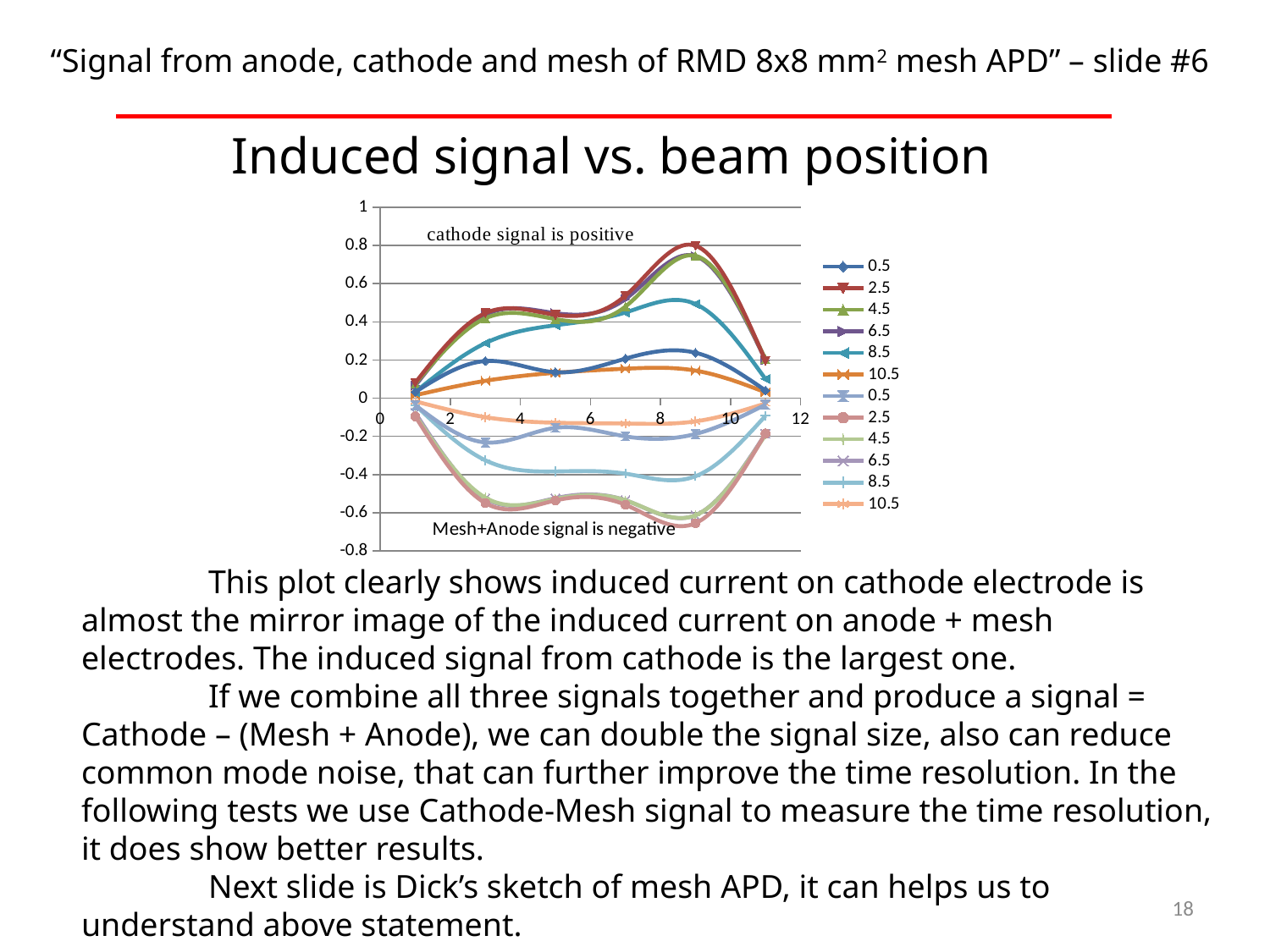
Is the value of the lower 6.5 series at x = 4 greater or less than -0.4? less Is the peak value of the upper 2.5 series (near x = 9) greater or less than 0.6? greater How many series does the legend of the chart list? 12 Is the highest value of the upper 10.5 series greater or less than 0.4? less According to the annotation in the upper part of the chart, which signal is positive? cathode signal What kind of chart is shown on the slide? line chart What is the title of the chart? Induced signal vs. beam position